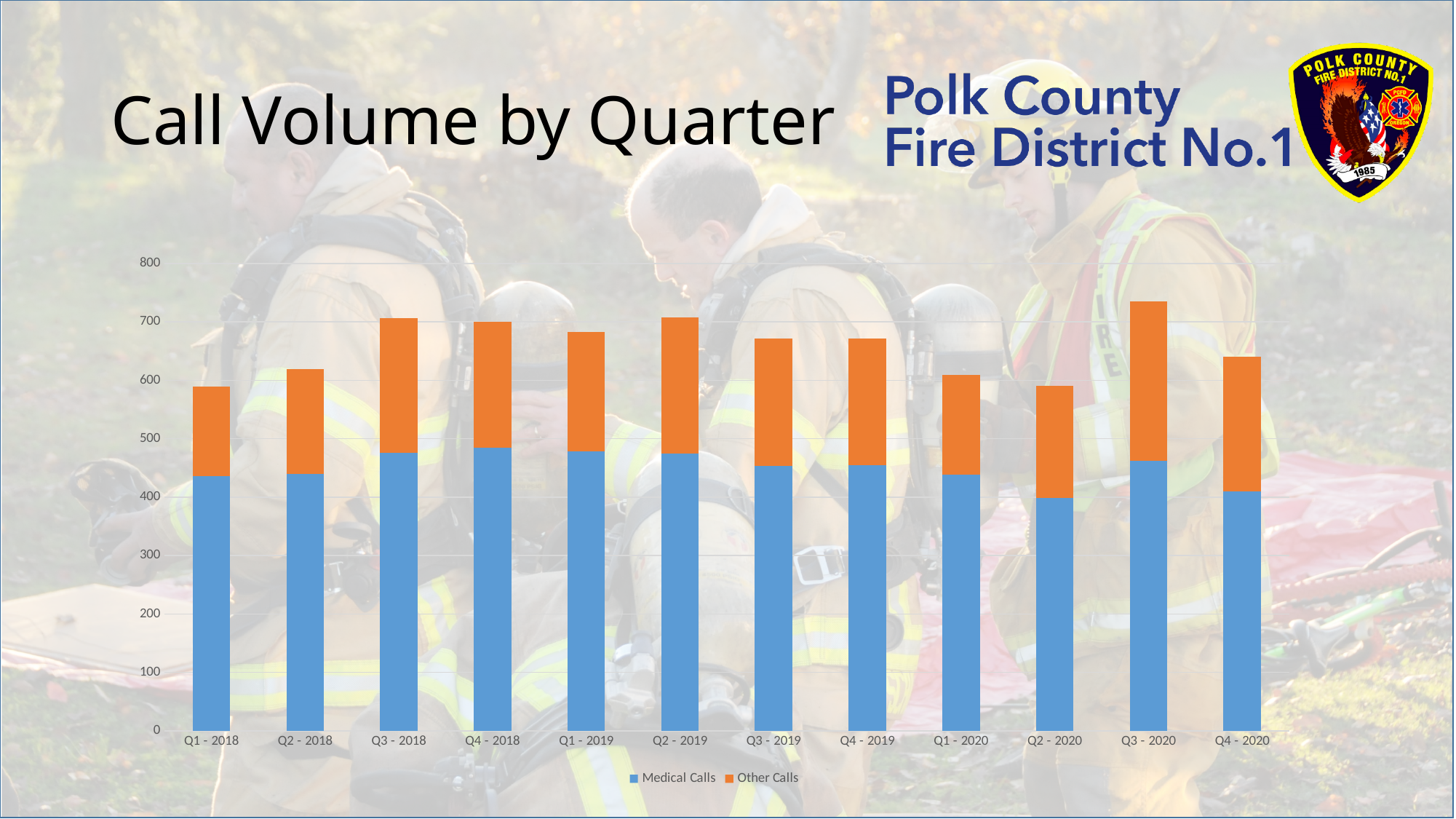
Is the total call volume for Q1 - 2018 greater or less than 600? less How many quarters are plotted on the x axis of the chart? 12 How many series does the chart's legend list? 2 Is the total call volume for Q4 - 2020 greater or less than 600? greater What is the title of the chart on the slide? Call Volume by Quarter Which quarter has the highest total call volume? Q3 - 2020 Which colour represents Medical Calls in the chart? Blue Which quarter has the larger total call volume, Q3 - 2020 or Q4 - 2020? Q3 - 2020 What kind of chart is shown on the slide? Stacked bar chart Is the total call volume for Q3 - 2020 greater or less than 700? greater